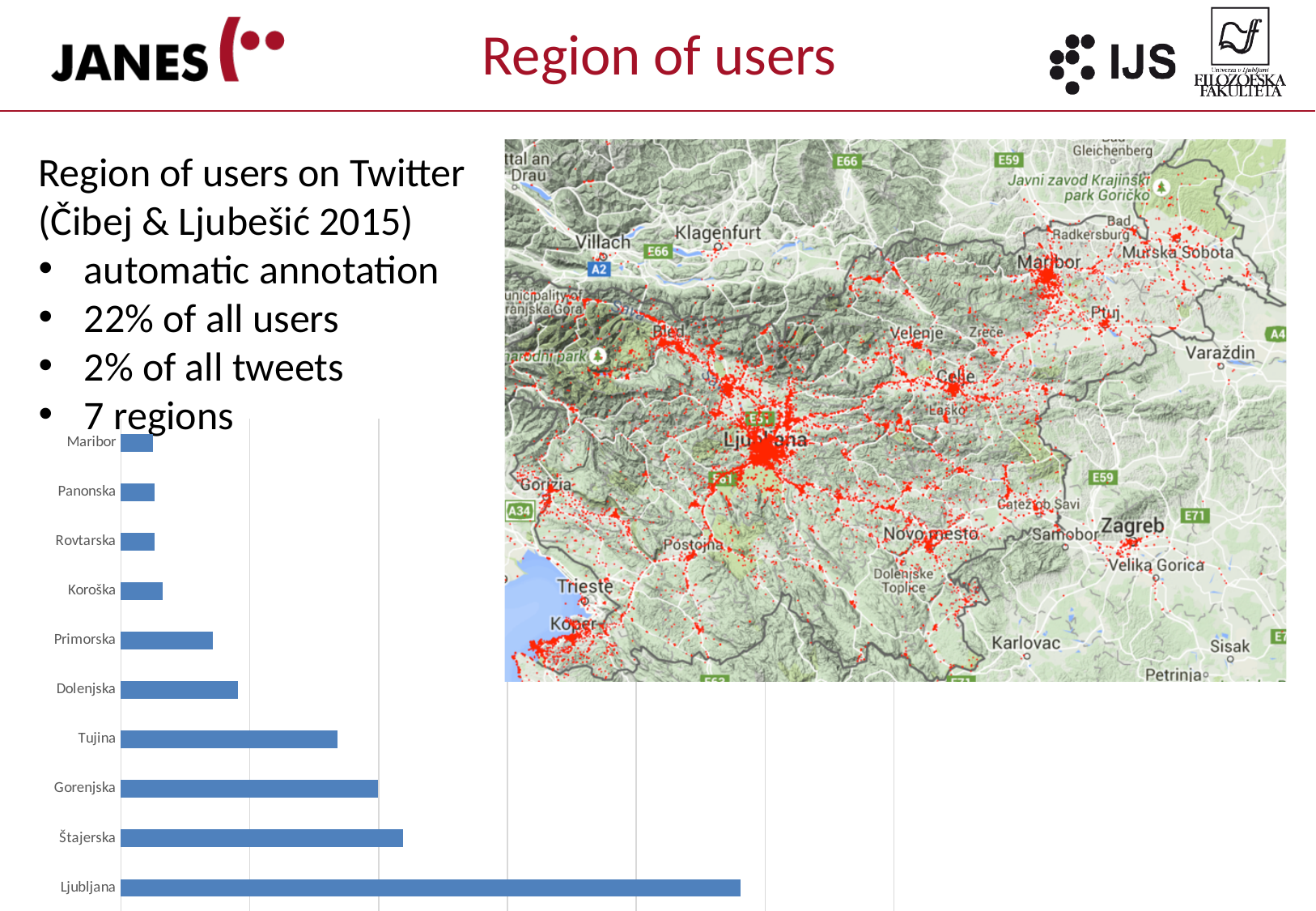
Which has the larger value, Gorenjska or Tujina? Gorenjska Which has the larger value, Ljubljana or Štajerska? Ljubljana Which has the larger value, Dolenjska or Primorska? Dolenjska How many categories (regions) are plotted in the bar chart? 10 Which category is listed at the top of the bar chart? Maribor Which region has the highest value in the bar chart? Ljubljana What colour are the bars in the chart? blue What kind of chart is shown on the slide? bar chart Which region has the second-longest bar in the chart? Štajerska